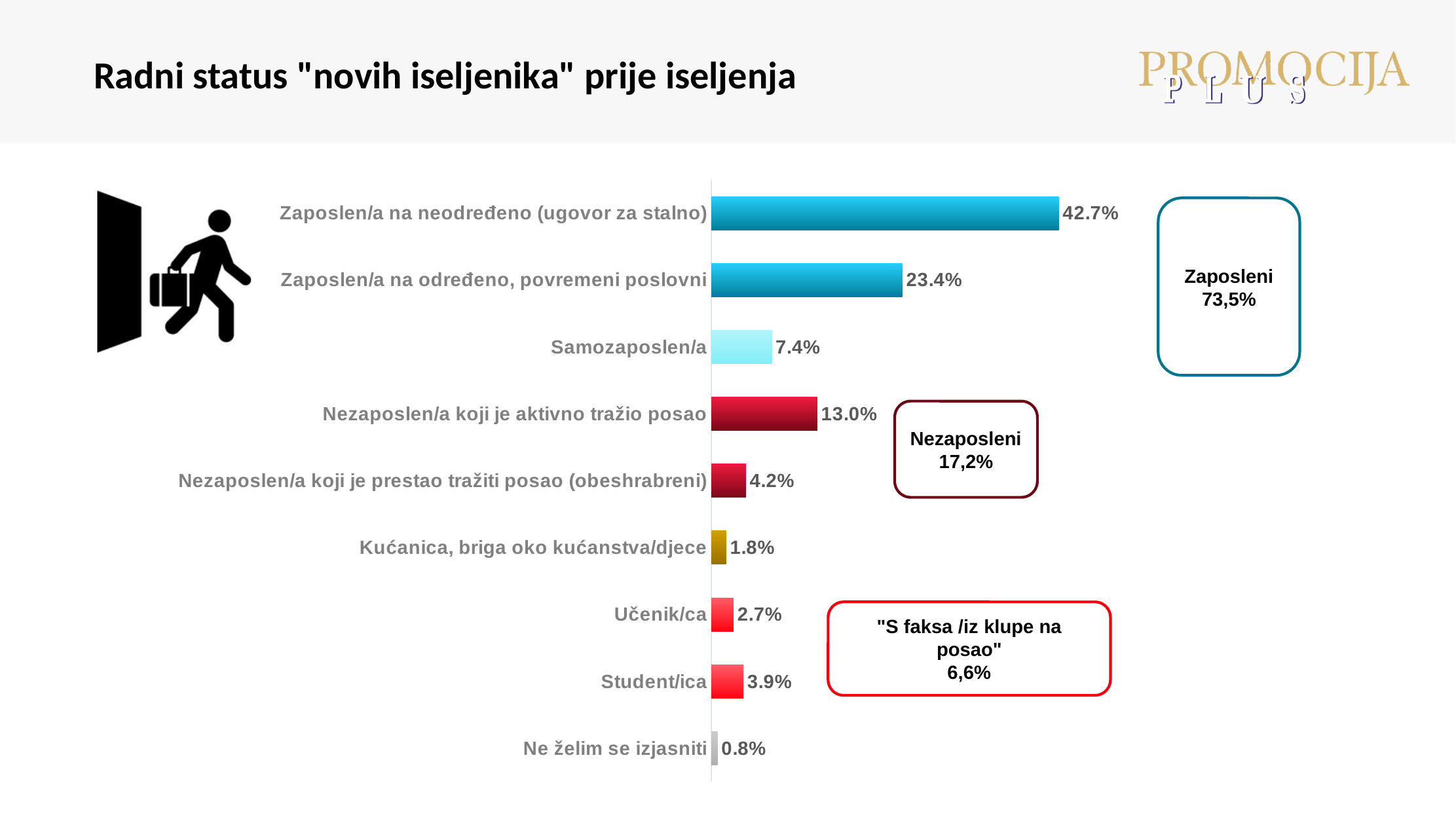
Which category has the lowest value? Ne želim se izjasniti What is the difference between "Nezaposlen/a koji je aktivno tražio posao" and "Nezaposlen/a koji je prestao tražiti posao (obeshrabreni)"? 8.8% What is the value for "Nezaposlen/a koji je aktivno tražio posao"? 13.0% What is the value for "Samozaposlen/a"? 7.4% What is the value for "Zaposlen/a na neodređeno (ugovor za stalno)"? 42.7% Which category has the highest value? Zaposlen/a na neodređeno (ugovor za stalno) What is the title of the slide? Radni status "novih iseljenika" prije iseljenja Which is larger, "Student/ica" or "Učenik/ca"? Student/ica How many categories are shown in the chart? 9 What is the value for "Kućanica, briga oko kućanstva/djece"? 1.8% What kind of chart is shown on the slide? Bar chart What is the difference between "Zaposlen/a na neodređeno (ugovor za stalno)" and "Zaposlen/a na određeno, povremeni poslovni"? 19.3%